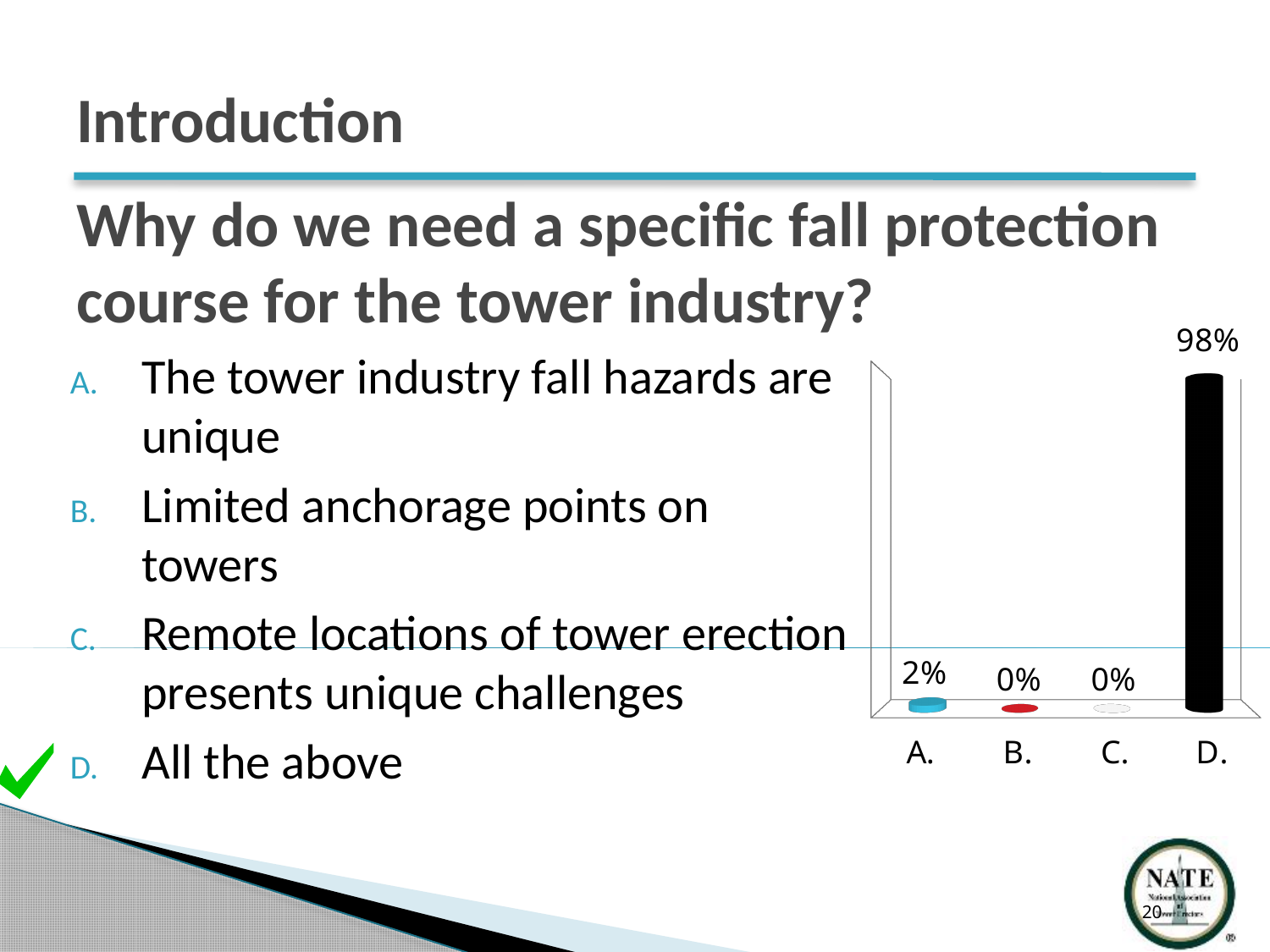
What colour is the bar for category D.? black Which is larger, the value for A. or the value for D.? D. What kind of chart is shown on the slide? bar chart What colour is the bar for category A.? blue What is the total of the values for A., B., C. and D.? 100% What is the value for category D. in the chart? 98% How many categories are shown in the chart? 4 Which category has the highest value in the chart? D. What is the value for category A. in the chart? 2% What is the difference between the values for D. and A.? 96% What is the value for category B. in the chart? 0% What is the value for category C. in the chart? 0%